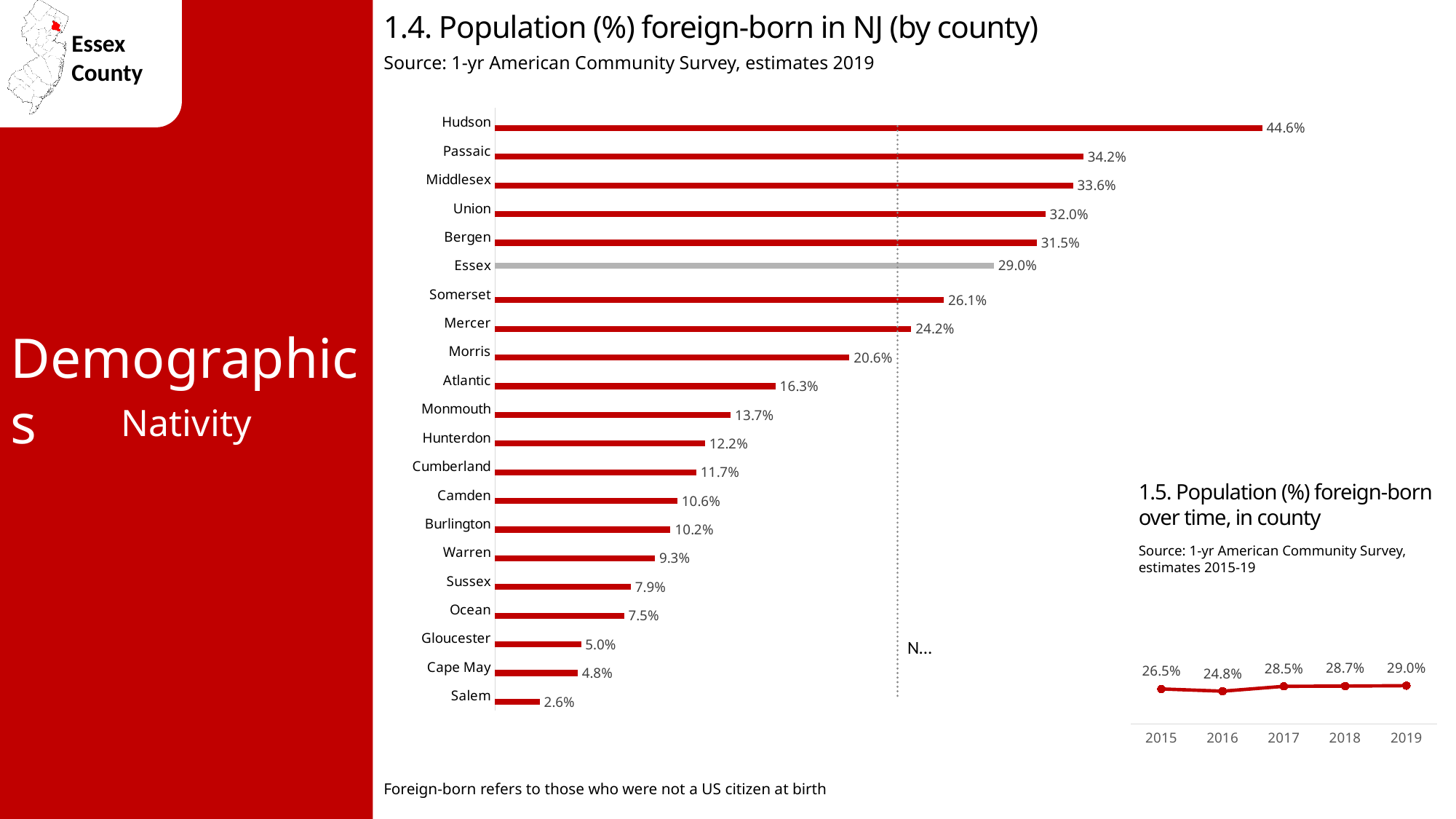
In the chart '1.4. Population (%) foreign-born in NJ (by county)', how many counties are shown? 21 In the chart '1.5. Population (%) foreign-born over time, in county', which year has the lowest value? 2016 In the chart '1.4. Population (%) foreign-born in NJ (by county)', which county has the lowest value? Salem In the chart '1.4. Population (%) foreign-born in NJ (by county)', what is the value for Cape May? 4.8% What kind of chart is '1.4. Population (%) foreign-born in NJ (by county)'? Bar chart In the chart '1.4. Population (%) foreign-born in NJ (by county)', which is larger, Morris or Atlantic? Morris In the chart '1.5. Population (%) foreign-born over time, in county', what is the difference between 2019 and 2015? 2.5% What kind of chart is '1.5. Population (%) foreign-born over time, in county'? Line chart In the chart '1.4. Population (%) foreign-born in NJ (by county)', what is the value for Essex? 29.0% In the chart '1.4. Population (%) foreign-born in NJ (by county)', what is the difference between Hudson and Passaic? 10.4% In the chart '1.5. Population (%) foreign-born over time, in county', what is the value for 2016? 24.8% In the chart '1.4. Population (%) foreign-born in NJ (by county)', which county has the highest value? Hudson